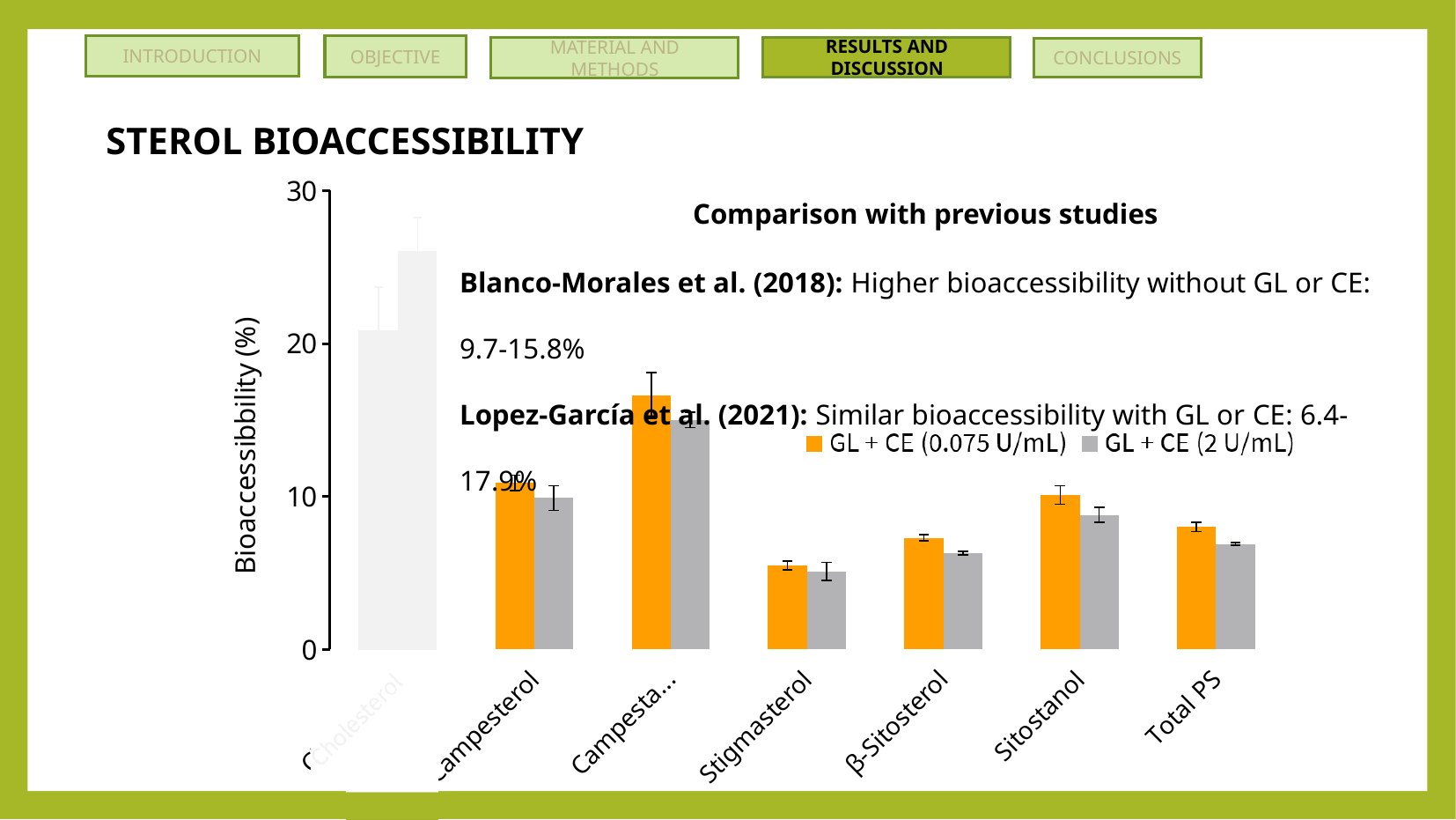
Is the GL + CE (2 U/mL) value for Total PS greater or less than 10? less Is the GL + CE (0.075 U/mL) value for Stigmasterol greater or less than 10? less What are the two series named in the chart legend? GL + CE (0.075 U/mL) and GL + CE (2 U/mL) For the GL + CE (0.075 U/mL) series, which is larger: Stigmasterol or β-Sitosterol? β-Sitosterol For Sitostanol, which series has the larger bar: GL + CE (0.075 U/mL) or GL + CE (2 U/mL)? GL + CE (0.075 U/mL) Is the GL + CE (2 U/mL) value for Cholesterol greater or less than 20? greater What kind of chart is shown on the slide? Bar chart Which category has the highest GL + CE (2 U/mL) bar? Cholesterol How many series does the chart legend list? 2 What is the label of the vertical axis of the chart? Bioaccessibbility (%) Which category has the lowest GL + CE (0.075 U/mL) bar? Stigmasterol How many categories are shown along the x axis of the chart? 7